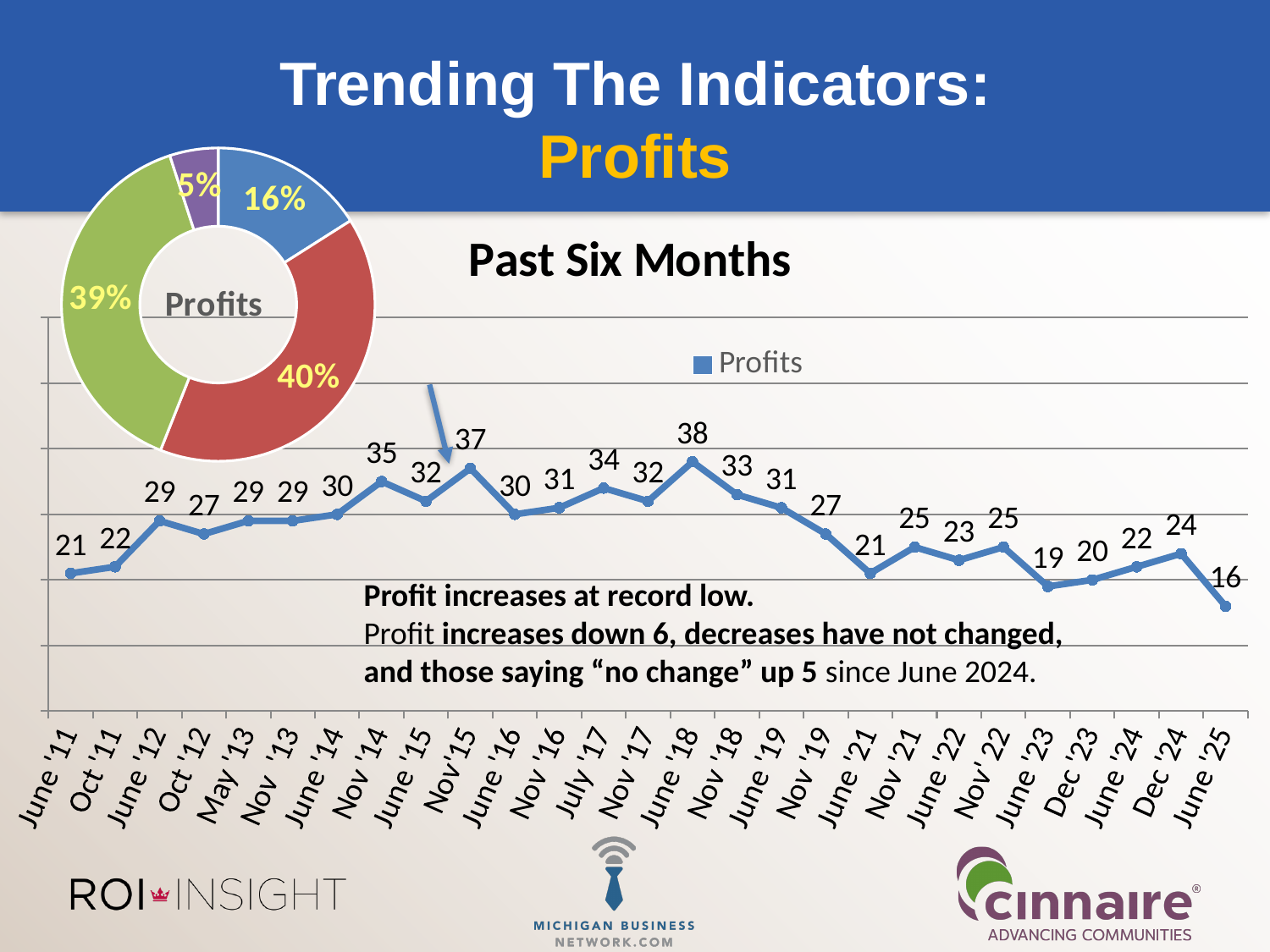
In the line chart titled 'Past Six Months', which is larger, the value for Nov '14 or the value for June '15? Nov '14 In the line chart titled 'Past Six Months', what is the value for Nov '15? 37 In the line chart titled 'Past Six Months', which period has the highest value? June '18 In the line chart titled 'Past Six Months', which period has the lowest value? June '25 In the donut chart titled 'Profits' at the top left, what is the largest slice's share? 40% In the line chart titled 'Past Six Months', do the values rise or fall from June '18 to June '25? fall In the line chart titled 'Past Six Months', what is the difference between the values for Dec '24 and June '25? 8 In the line chart titled 'Past Six Months', what is the value for June '25? 16 In the line chart titled 'Past Six Months', how many series does the legend list? 1 In the line chart titled 'Past Six Months', what is the value for June '18? 38 In the donut chart titled 'Profits' at the top left, what is the smallest slice's share? 5% In the line chart titled 'Past Six Months', how many data points are plotted? 27